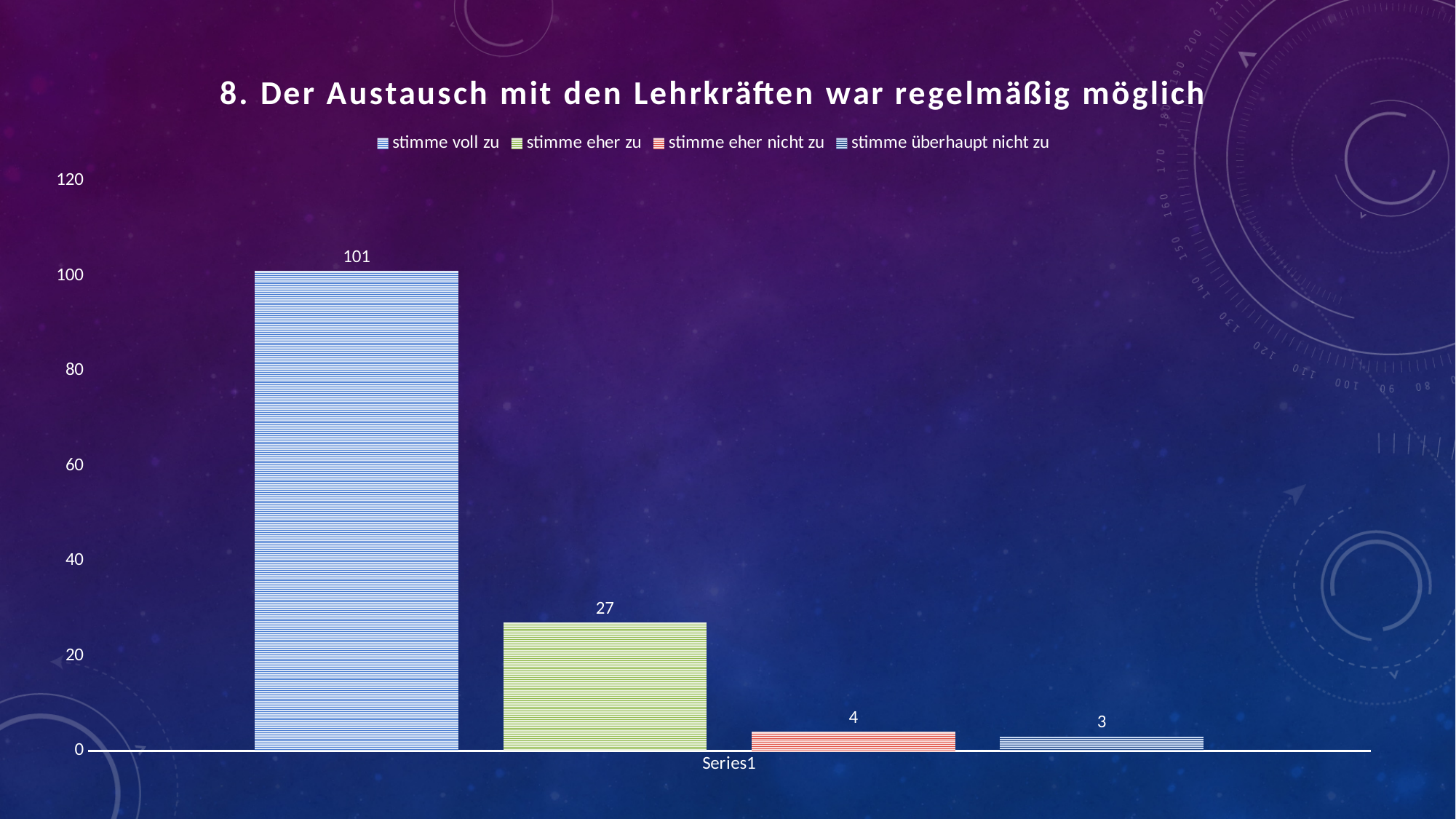
Which series has the highest value? stimme voll zu What is the difference between the values for "stimme voll zu" and "stimme eher zu"? 74 What is the value for "stimme eher nicht zu"? 4 How many series does the legend list? 4 Is the value for "stimme voll zu" greater or less than 80? greater Which is larger, the value for "stimme eher zu" or the value for "stimme eher nicht zu"? stimme eher zu What is the value for "stimme voll zu"? 101 Which series has the lowest value? stimme überhaupt nicht zu What is the value for "stimme eher zu"? 27 What is the title of the chart? 8. Der Austausch mit den Lehrkräften war regelmäßig möglich What is the value for "stimme überhaupt nicht zu"? 3 What kind of chart is shown on the slide? bar chart